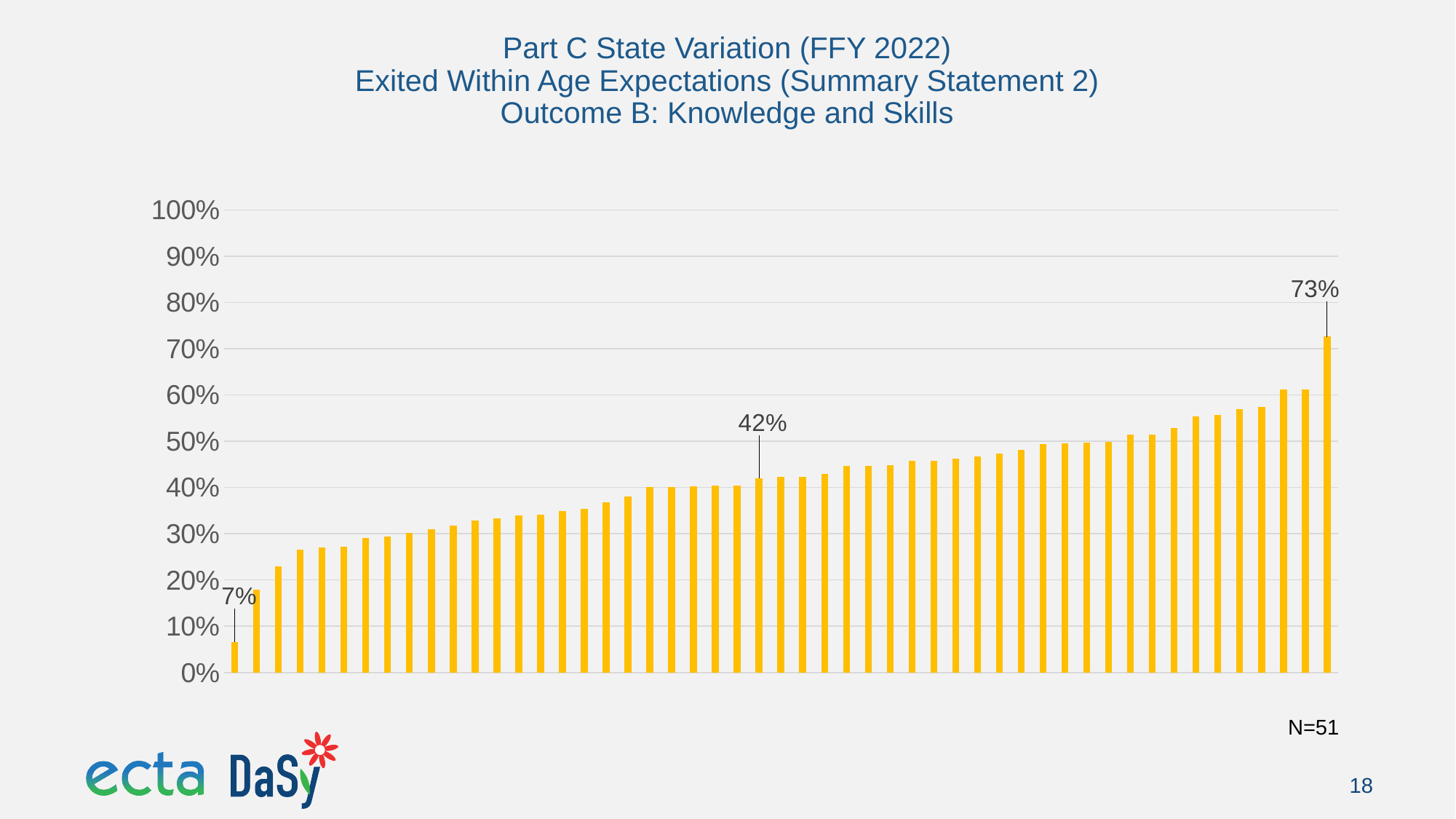
What is the difference between the highest labeled value (73%) and the lowest labeled value (7%)? 66% What value is labeled on the bar in the middle of the chart? 42% What is the difference between the highest labeled value (73%) and the middle labeled value (42%)? 31% What fiscal year does the chart title refer to? FFY 2022 Is the value of the tallest bar greater or less than 70%? greater What is the highest value shown on the chart? 73% What is the lowest value shown on the chart? 7% Do the bar values rise or fall from left to right across the chart? rise Is the value of the shortest bar greater or less than 10%? less What kind of chart is shown on the slide? bar chart According to the N value printed on the slide, how many states are represented in the chart? 51 Which outcome does the chart title say the data is for? Outcome B: Knowledge and Skills